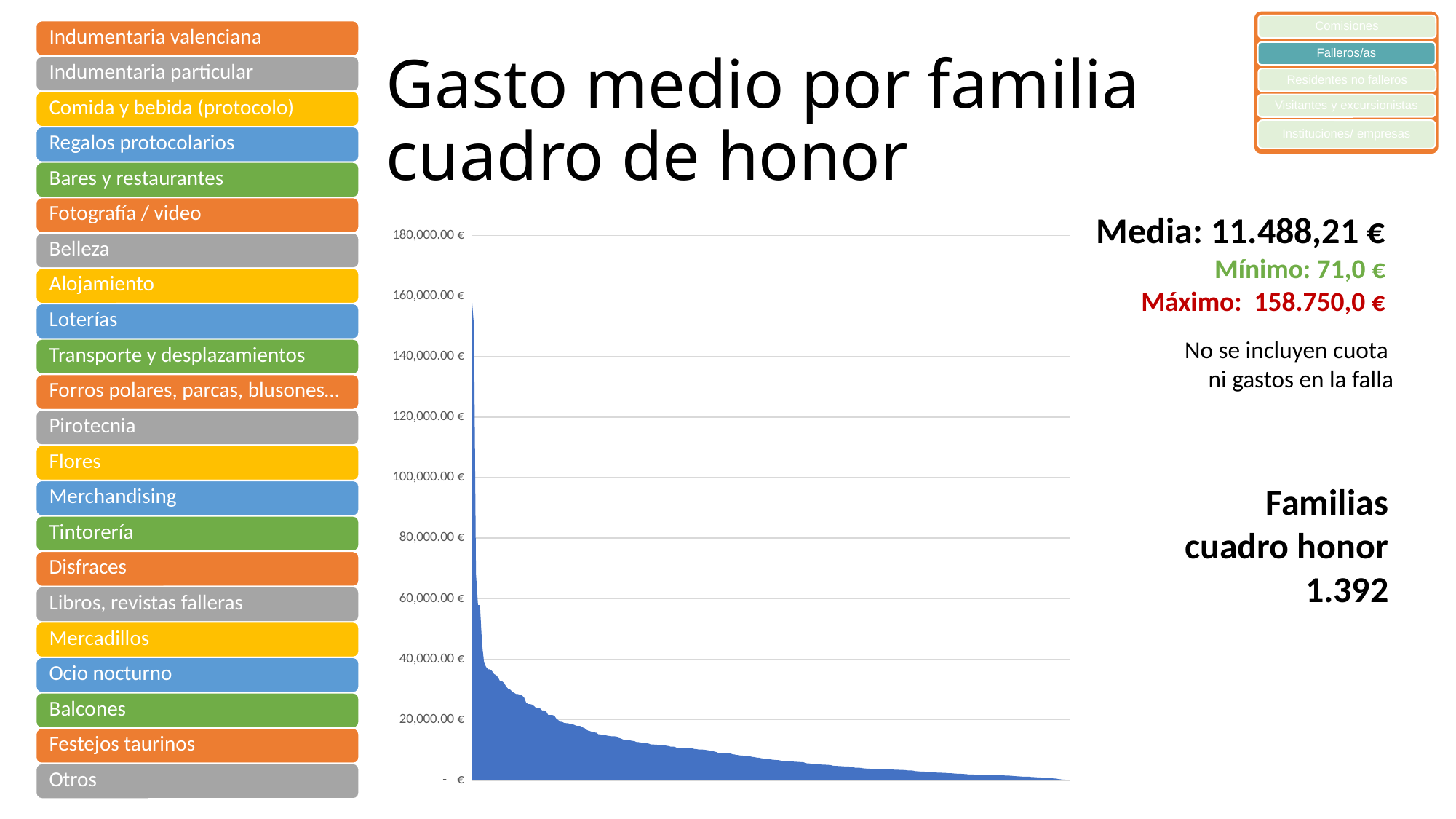
Is the value at the far right end of the chart greater or less than 20,000.00 €? less What is the minimum (Mínimo) spending per family stated on the slide? 71,0 € What is the average (Media) spending per family stated on the slide? 11.488,21 € Is the highest value plotted in the chart greater or less than 140,000.00 €? greater What is the title of the slide containing the chart? Gasto medio por familia cuadro de honor Do the values in the chart rise or fall from left to right along the x axis? fall What kind of chart is shown on the slide? area chart What is the highest tick value shown on the chart's vertical axis? 180,000.00 € What is the maximum (Máximo) spending per family stated on the slide? 158.750,0 €